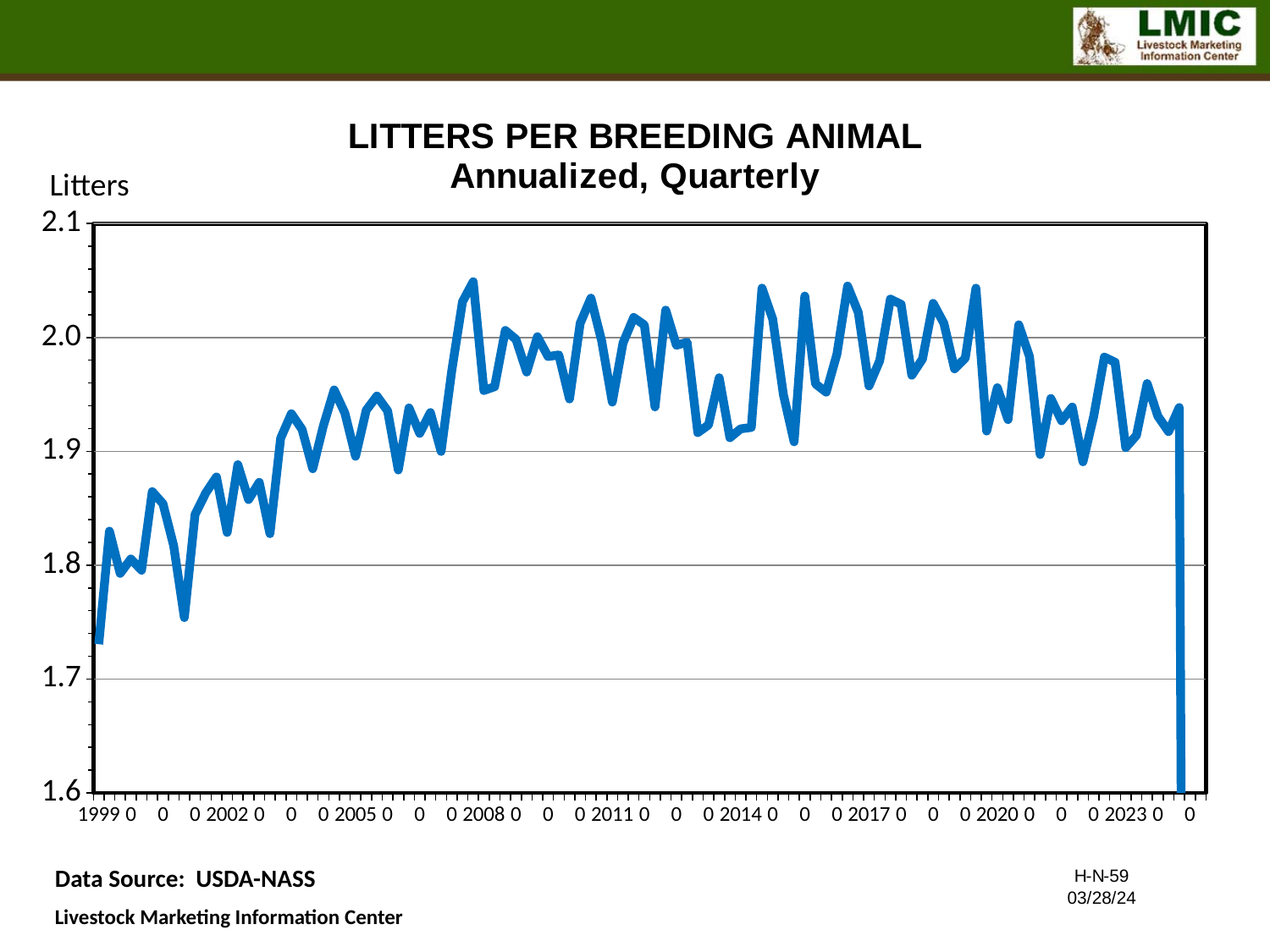
Is the value at the 2017 tick greater or less than 2.0? less What label is shown on the vertical axis of the chart? Litters Which is larger, the value at the start of 1999 or the value at 2008? 2008 What kind of chart is shown on the slide? line chart What is the lowest value shown on the vertical axis? 1.6 What data source is cited for the chart? USDA-NASS What is the title of the chart? LITTERS PER BREEDING ANIMAL Annualized, Quarterly Does the line generally rise or fall between 1999 and 2008? rise Is the peak value around 2008 greater or less than 2.0? greater What is the highest value shown on the vertical axis? 2.1 Is the value at the start of 1999 greater or less than 1.8? less How many years are labeled on the horizontal axis? 9